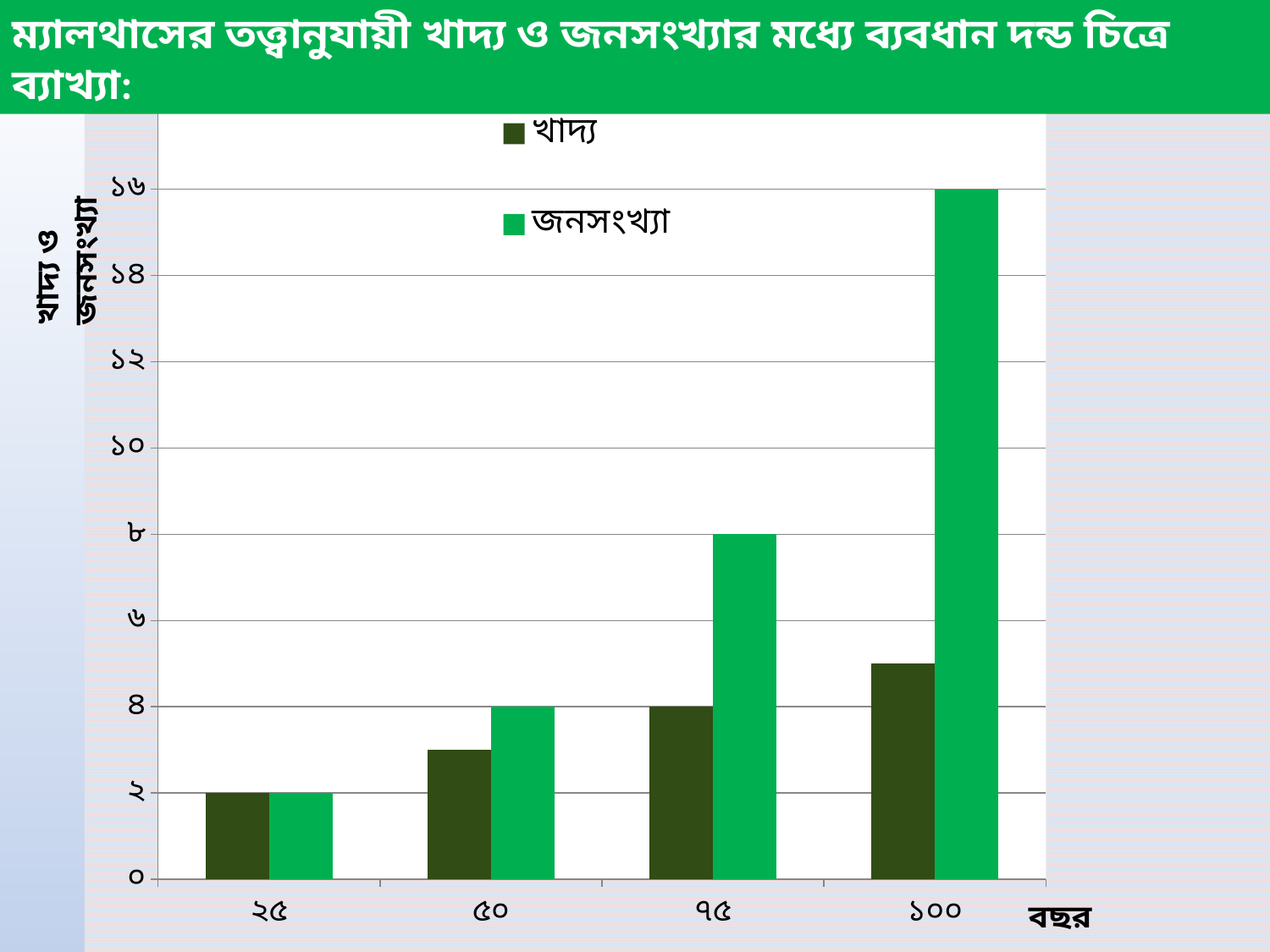
Is the value of খাদ্য at ১০০ greater or less than ৬? less Is the value of খাদ্য at ৫০ greater or less than ২? greater What kind of chart is shown on the slide? bar chart What is the value of খাদ্য at ২৫? ২ At which category is জনসংখ্যা highest? ১০০ Do the জনসংখ্যা values rise or fall from ২৫ to ১০০? rise What is the difference between জনসংখ্যা and খাদ্য at ৭৫? ৪ What is the value of খাদ্য at ৭৫? ৪ What is the value of জনসংখ্যা at ১০০? ১৬ How many categories are shown on the x axis? 4 How many series does the legend list? 2 What is the value of জনসংখ্যা at ৭৫? ৮